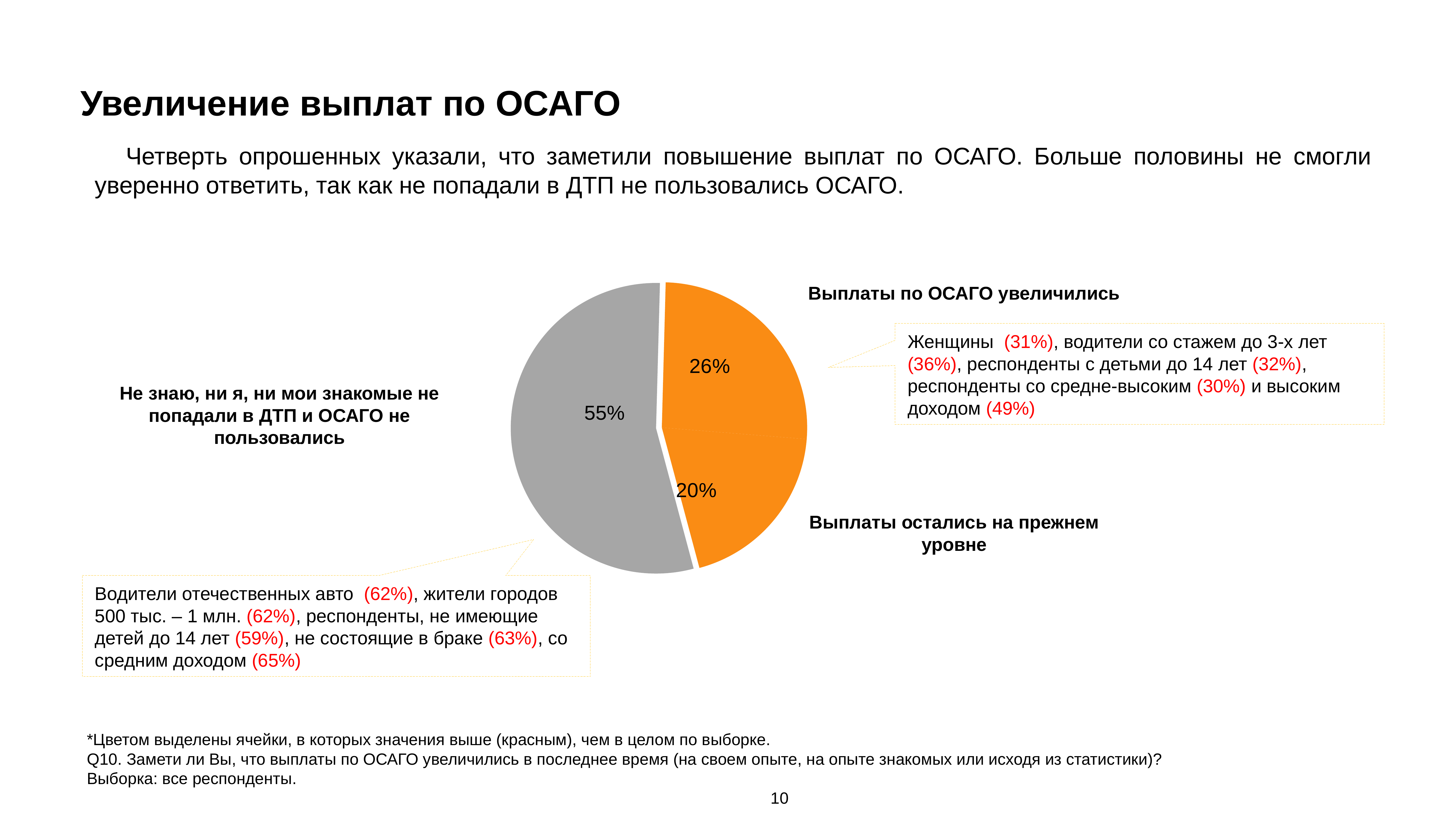
What colour is the slice for "Не знаю, ни я, ни мои знакомые не попадали в ДТП и ОСАГО не пользовались"? grey Which answer option has the smallest slice of the pie? Выплаты остались на прежнем уровне What is the title of the slide containing the pie chart? Увеличение выплат по ОСАГО Which answer option has the largest slice of the pie? Не знаю, ни я, ни мои знакомые не попадали в ДТП и ОСАГО не пользовались What is the difference in percentage points between the "Не знаю..." slice and the "Выплаты по ОСАГО увеличились" slice? 29 What share of respondents answered "Не знаю, ни я, ни мои знакомые не попадали в ДТП и ОСАГО не пользовались"? 55% What share of respondents answered "Выплаты по ОСАГО увеличились"? 26% Which is larger: the share for "Выплаты по ОСАГО увеличились" or the share for "Выплаты остались на прежнем уровне"? Выплаты по ОСАГО увеличились What kind of chart is shown on the slide? pie chart What share of respondents answered "Выплаты остались на прежнем уровне"? 20% How many slices does the pie chart have? 3 What is the difference in percentage points between the "Выплаты по ОСАГО увеличились" slice and the "Выплаты остались на прежнем уровне" slice? 6